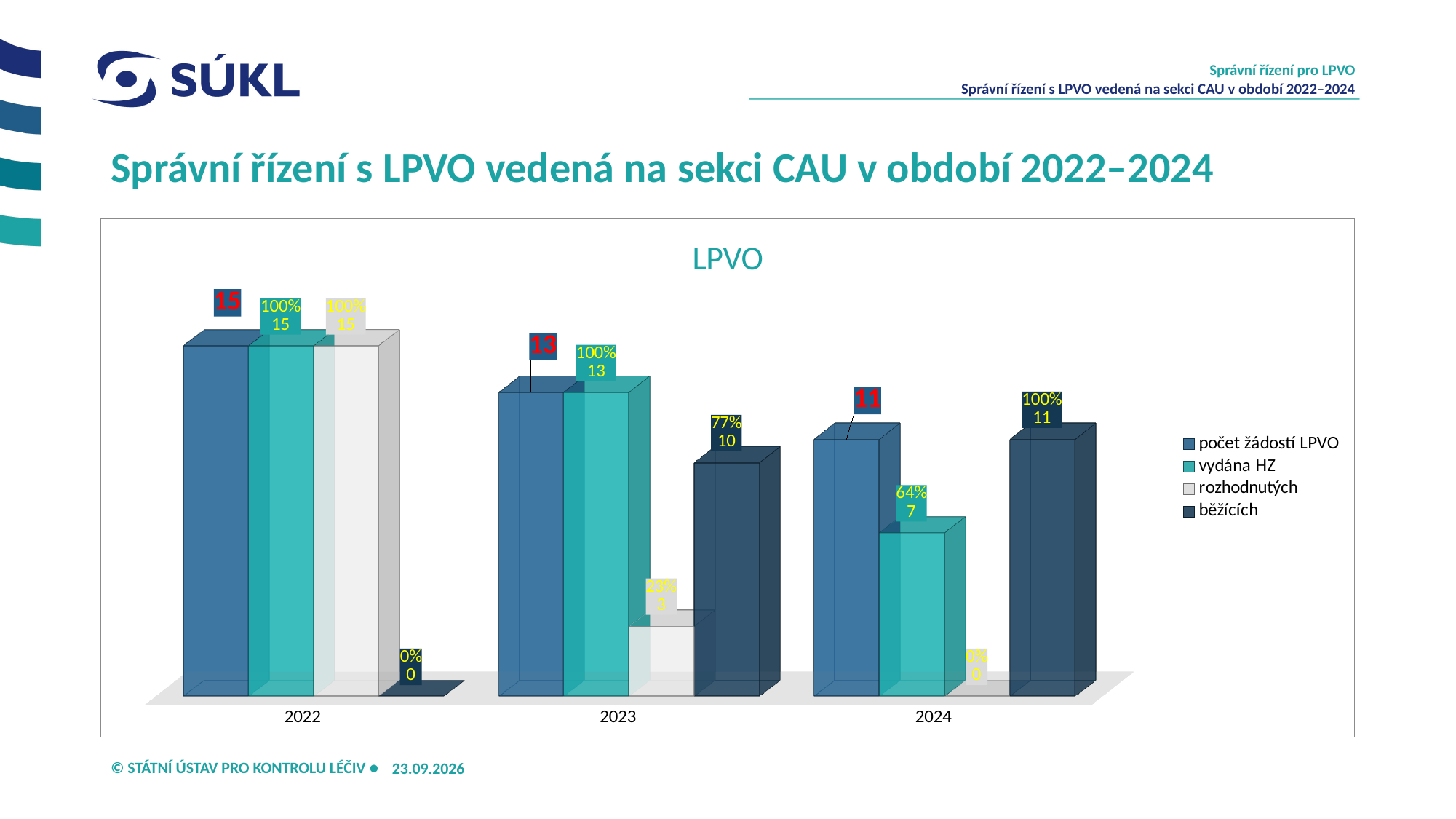
What is the value for rozhodnutých in 2024? 0 What is the value for počet žádostí LPVO in 2022? 15 Which year has the lowest value for vydána HZ? 2024 Does the value for počet žádostí LPVO rise or fall from 2022 to 2024? fall What kind of chart is shown? bar chart What is the value for vydána HZ in 2024? 7 Which year has the highest value for počet žádostí LPVO? 2022 What is the difference between počet žádostí LPVO in 2022 and in 2024? 4 What percentage is shown for rozhodnutých in 2023? 23% Which is larger in 2023: rozhodnutých or běžících? běžících What is the value for běžících in 2023? 10 How many series does the legend list? 4